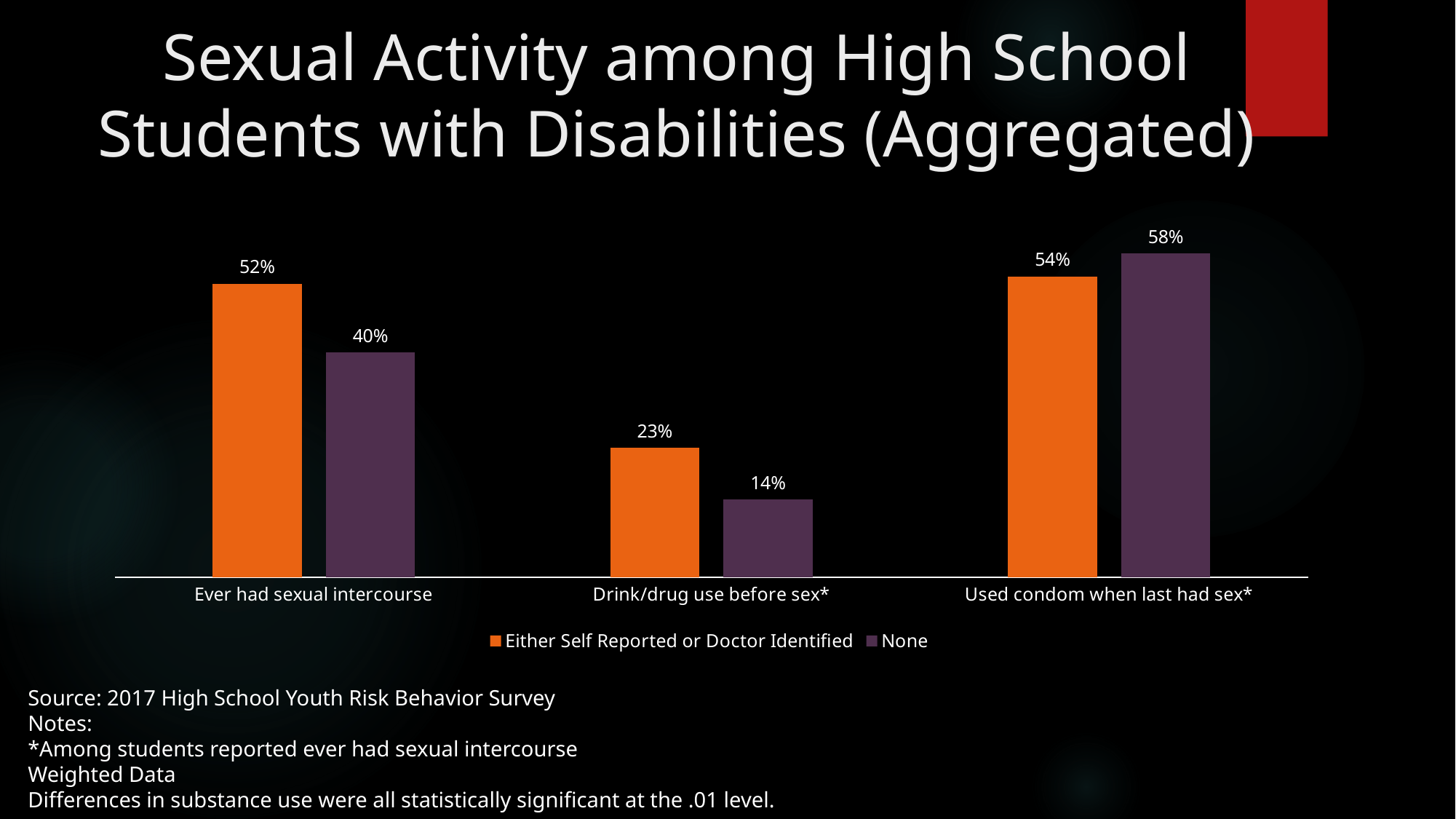
What is the value for 'None' in the 'Used condom when last had sex*' category? 58% In the 'Used condom when last had sex*' category, which series has the larger value? None What is the difference between the 'Either Self Reported or Doctor Identified' and 'None' values in the 'Drink/drug use before sex*' category? 9% What kind of chart is shown on the slide? Bar chart Which category has the highest value for the 'None' series? Used condom when last had sex* How many categories are shown on the x axis? 3 What is the difference between the 'Either Self Reported or Doctor Identified' and 'None' values in the 'Ever had sexual intercourse' category? 12% What is the value for 'Either Self Reported or Doctor Identified' in the 'Used condom when last had sex*' category? 54% What is the value for 'Either Self Reported or Doctor Identified' in the 'Ever had sexual intercourse' category? 52% Which category has the lowest value for the 'Either Self Reported or Doctor Identified' series? Drink/drug use before sex* What is the value for 'None' in the 'Drink/drug use before sex*' category? 14% How many series does the legend list? 2